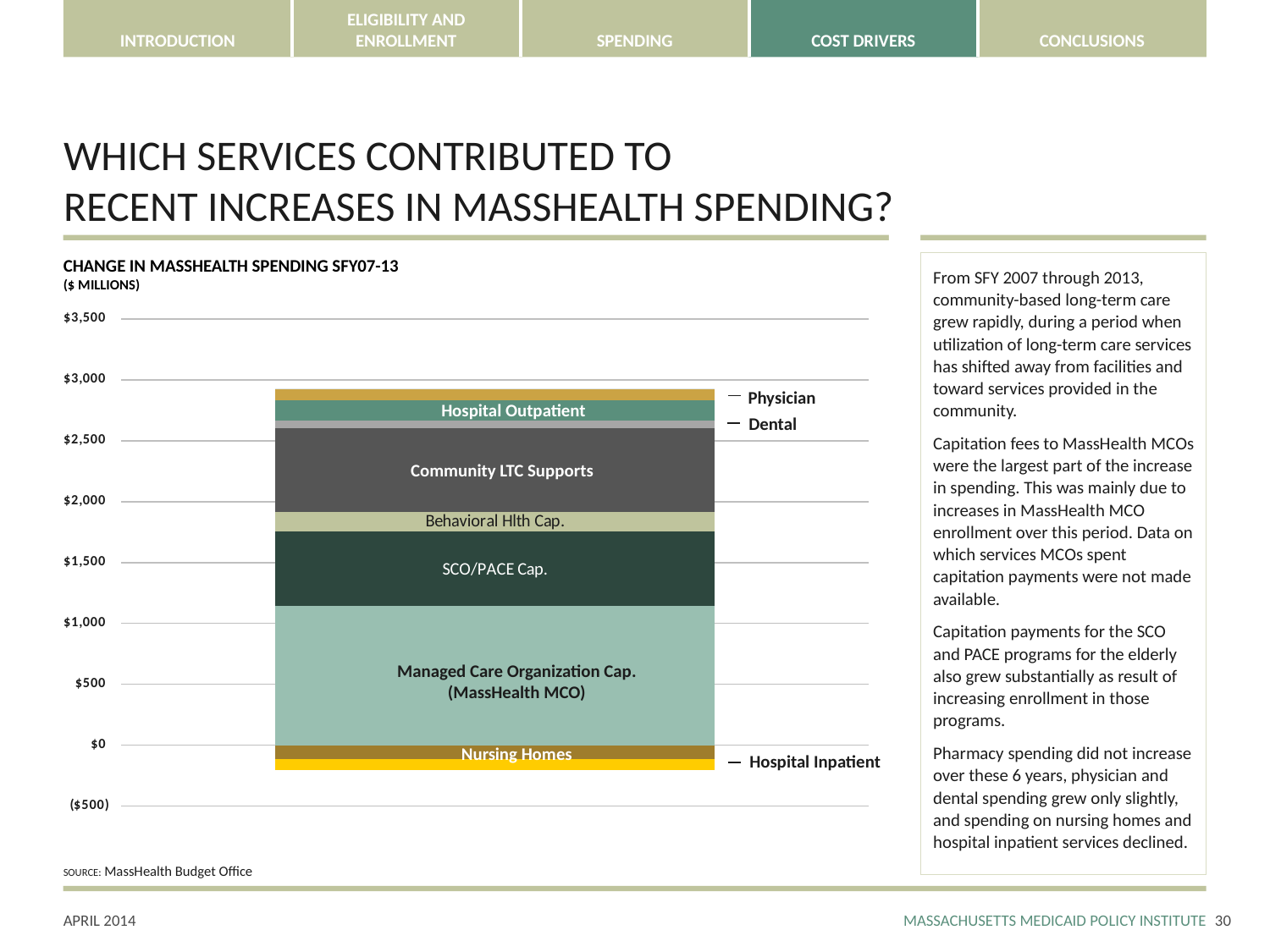
Which segment sits at the very top of the stacked bar? Physician Is the top of the stacked bar (the total of the positive segments) greater or less than $2,500? greater Which service categories are shown below $0 (as decreases) in the chart? Nursing Homes and Hospital Inpatient Which segment is larger, Community LTC Supports or Hospital Outpatient? Community LTC Supports What kind of chart is shown on the slide? Stacked bar chart Which segment is larger, SCO/PACE Cap. or Behavioral Hlth Cap.? SCO/PACE Cap. Is the top of the stacked bar (the total of the positive segments) greater or less than $3,000? less In what units are the values on the chart expressed? $ millions Which service category is the largest segment of the stacked bar? Managed Care Organization Cap. (MassHealth MCO) How many service categories (segments) are shown in the stacked bar? 9 Is the value for SCO/PACE Cap. greater or less than $1,000? less